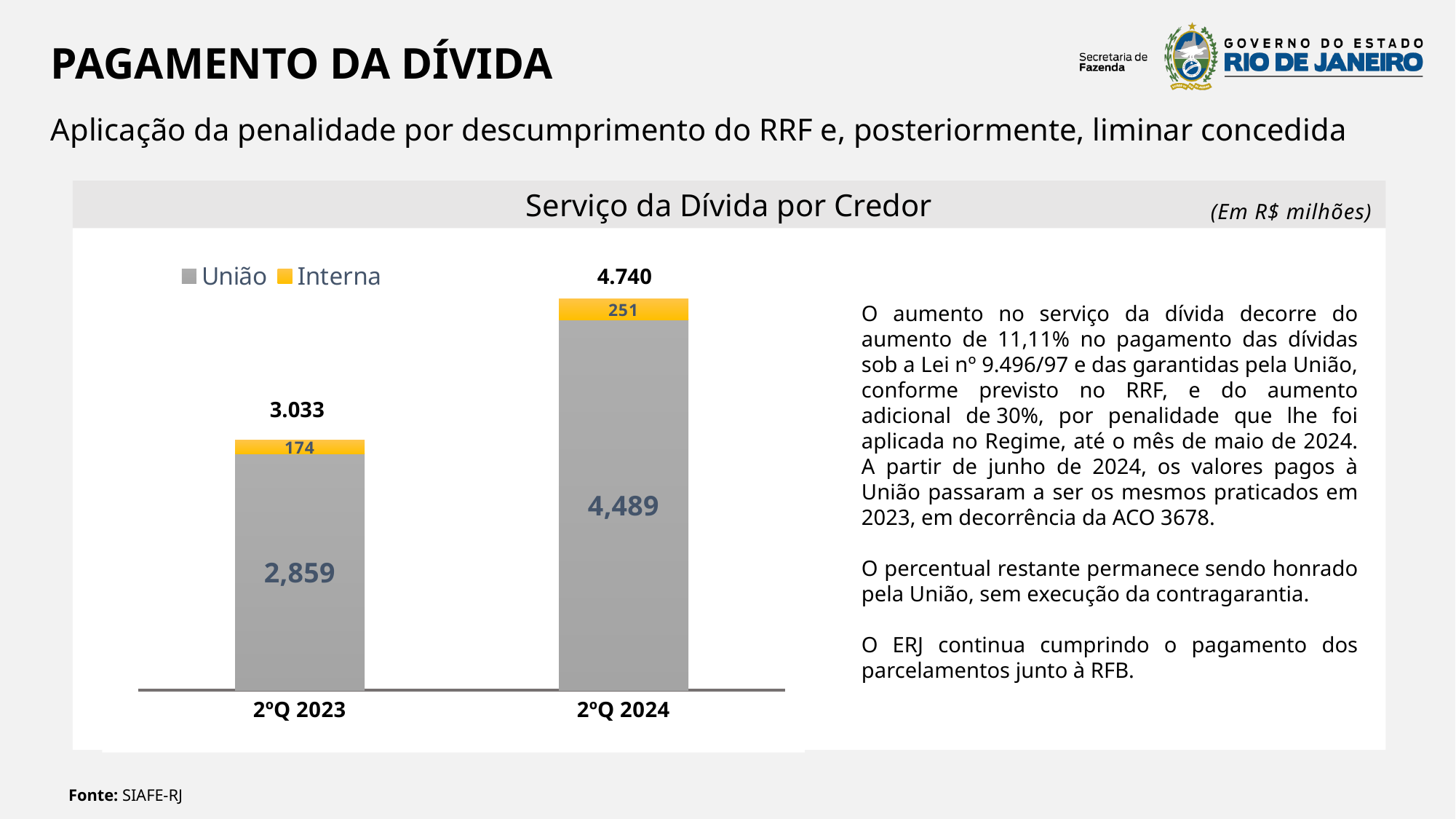
What is the title of the chart? Serviço da Dívida por Credor What is the value for Interna in 2ºQ 2023? 174 What is the value for União in 2ºQ 2023? 2,859 Which period has the higher total debt service, 2ºQ 2023 or 2ºQ 2024? 2ºQ 2024 What is the total of the stacked bar for 2ºQ 2023? 3.033 What is the difference between the Interna values for 2ºQ 2024 and 2ºQ 2023? 77 What is the difference between the União values for 2ºQ 2024 and 2ºQ 2023? 1,630 What is the total of the stacked bar for 2ºQ 2024? 4.740 What is the value for União in 2ºQ 2024? 4,489 What type of chart is shown on the slide? Stacked bar chart What is the value for Interna in 2ºQ 2024? 251 How many series does the legend list? 2